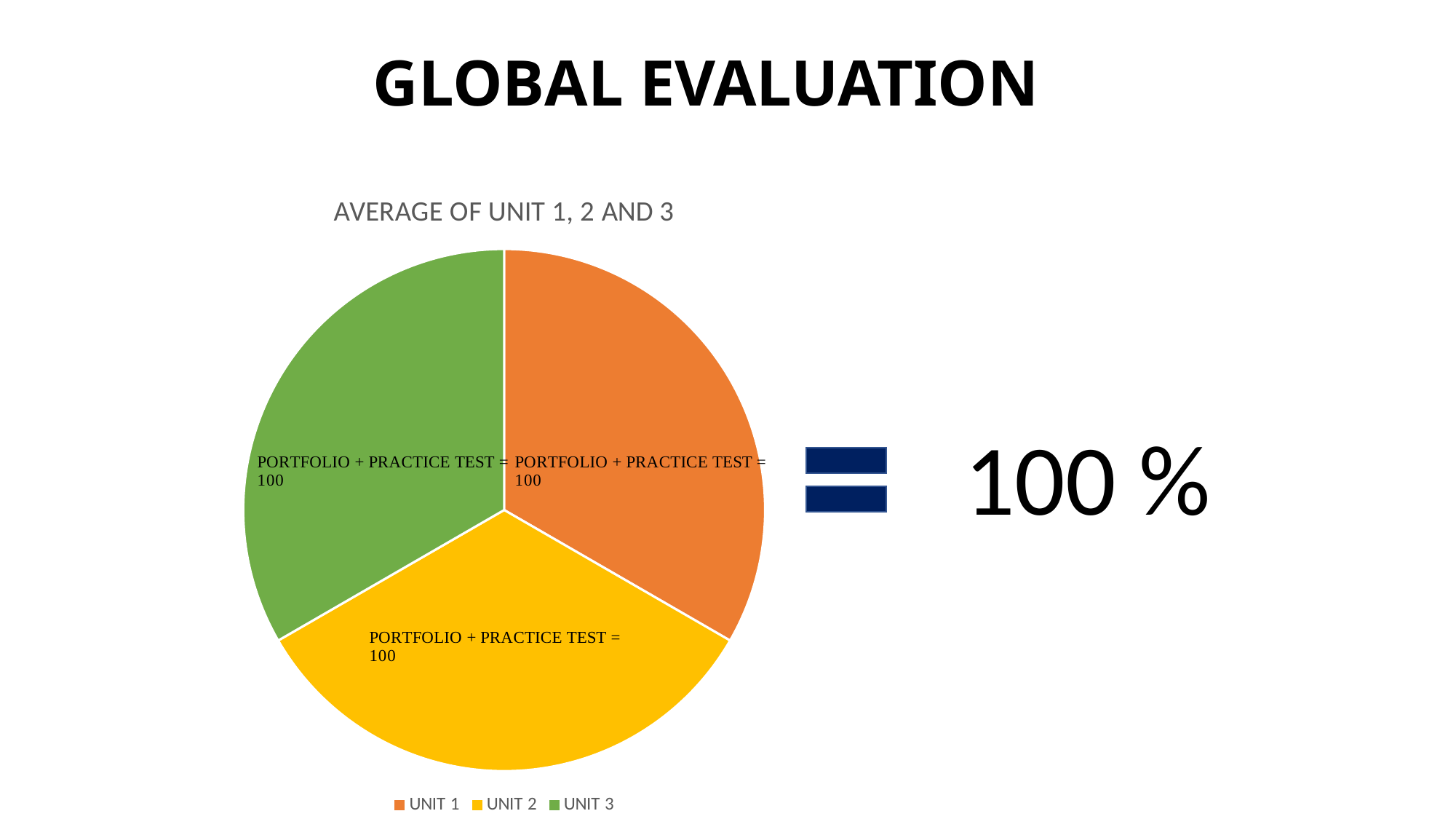
How many entries does the legend of the pie chart list? 3 What is the title of the pie chart? AVERAGE OF UNIT 1, 2 AND 3 What is the total of the three values printed on the pie chart slices? 300 What value is printed on the UNIT 2 slice of the pie chart? 100 What text is printed as the data label on each slice of the pie chart? PORTFOLIO + PRACTICE TEST = 100 How many slices does the pie chart have? 3 Which colour represents UNIT 2 in the pie chart legend? yellow What value is printed on the UNIT 1 slice of the pie chart? 100 What value is printed on the UNIT 3 slice of the pie chart? 100 What is the difference between the values printed for UNIT 1 and UNIT 3? 0 What kind of chart is shown on the slide? pie chart What share of the pie does the UNIT 2 slice represent? one third